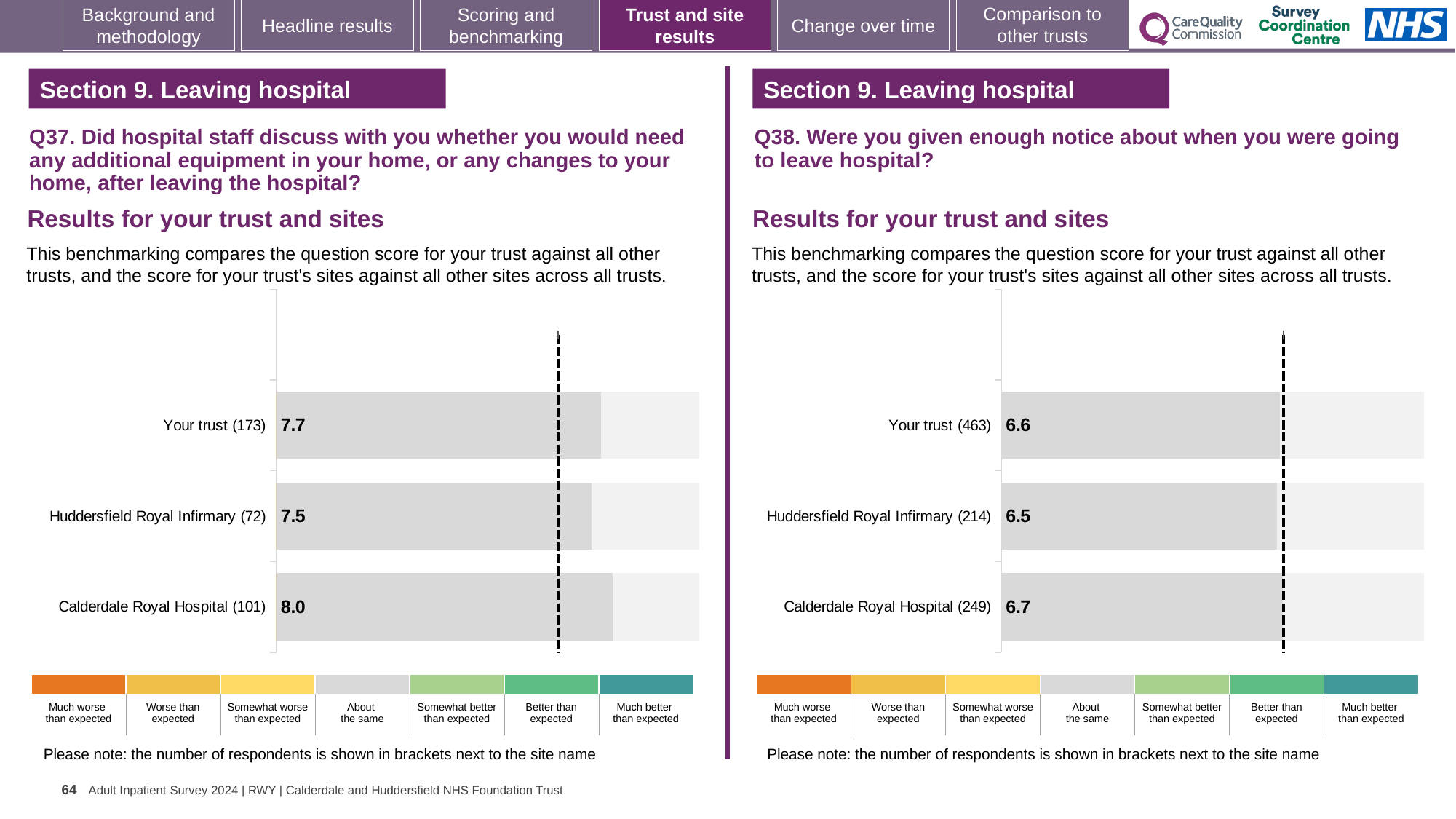
In the Q38 chart on the right, what is the score for Huddersfield Royal Infirmary? 6.5 In the Q38 chart on the right, what is the difference between the scores for Calderdale Royal Hospital and Your trust? 0.1 In the Q38 chart on the right, how many respondents are shown in brackets for Calderdale Royal Hospital? 249 In the Q37 chart on the left, what is the score for Calderdale Royal Hospital? 8.0 In the Q37 chart on the left, what is the score for Your trust? 7.7 How many bars are plotted in the Q37 chart on the left? 3 In the Q37 chart on the left, which site or trust has the highest score? Calderdale Royal Hospital In the Q38 chart on the right, what is the score for Your trust? 6.6 In the Q38 chart on the right, which site or trust has the highest score? Calderdale Royal Hospital What kind of chart is used for the Q38 results on the right? Bar chart In the Q37 chart on the left, what is the difference between the scores for Calderdale Royal Hospital and Huddersfield Royal Infirmary? 0.5 In the Q37 chart on the left, which site or trust has the lowest score? Huddersfield Royal Infirmary